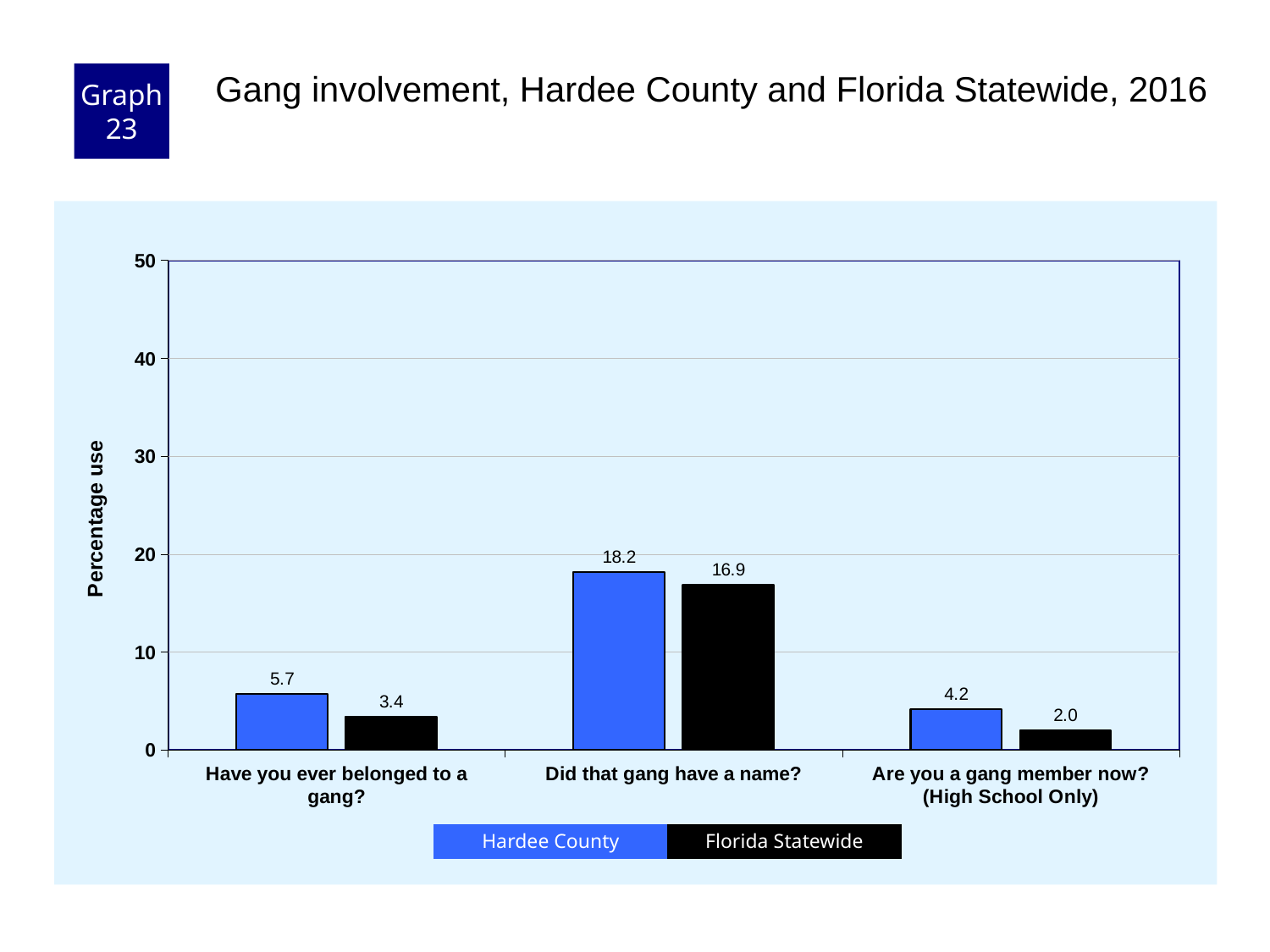
What is the Florida Statewide value for "Are you a gang member now? (High School Only)"? 2.0 What is the difference between the Hardee County and Florida Statewide values for "Did that gang have a name?"? 1.3 Which question has the lowest Florida Statewide value? Are you a gang member now? (High School Only) What is the Hardee County value for "Have you ever belonged to a gang?"? 5.7 How many questions (categories) are shown on the x axis? 3 What is the Florida Statewide value for "Did that gang have a name?"? 16.9 Which is larger for "Have you ever belonged to a gang?": Hardee County or Florida Statewide? Hardee County What is the difference between the Hardee County and Florida Statewide values for "Are you a gang member now? (High School Only)"? 2.2 Which question has the highest Hardee County value? Did that gang have a name? What kind of chart is shown on the slide? bar chart How many series does the legend list? 2 Is the Hardee County value for "Did that gang have a name?" greater or less than 20? less